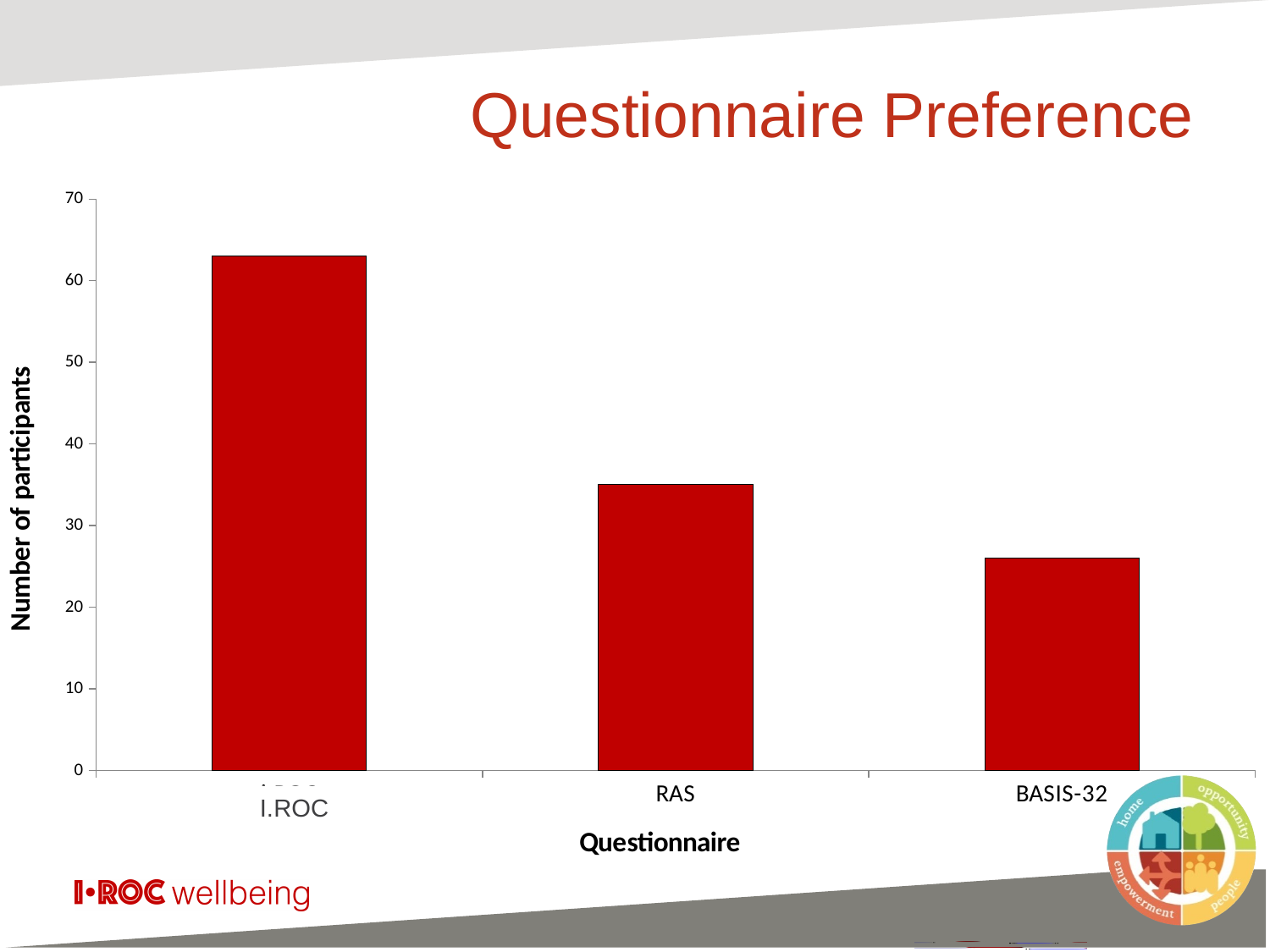
Is the value for RAS greater or less than 30? greater What type of chart is shown on the slide? bar chart Which has more participants, RAS or BASIS-32? RAS Which questionnaire has the lowest number of participants? BASIS-32 Is the value for RAS greater or less than 40? less Is the value for I.ROC greater or less than 60? greater Do the values rise or fall moving from left to right along the x axis? fall Which questionnaire has the highest number of participants? I.ROC What is the title of the chart? Questionnaire Preference How many questionnaires are shown on the x axis? 3